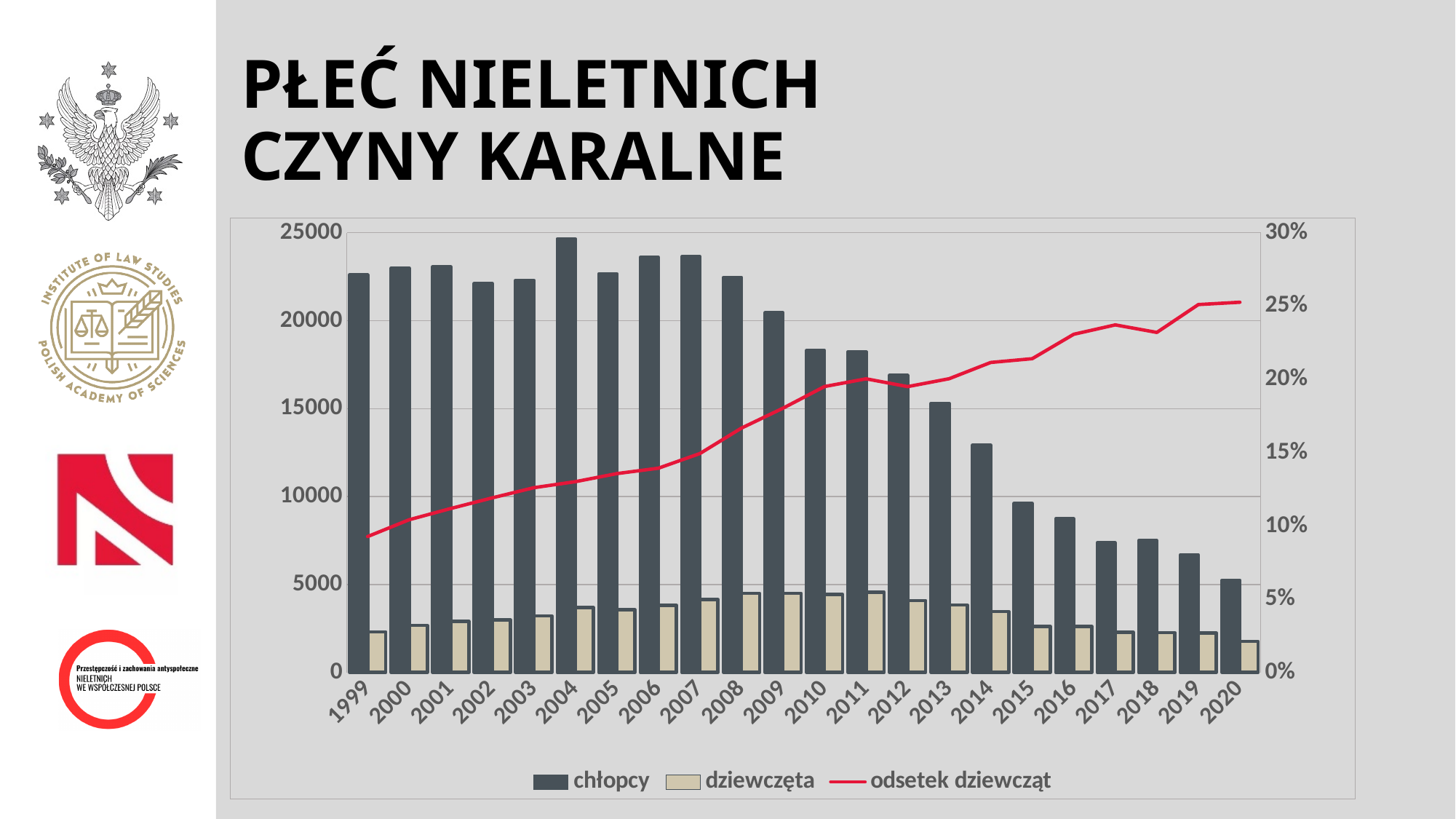
Is the value for chłopcy in 2004 greater or less than 20000? greater How many years are shown on the x axis? 22 Which is larger, the value for chłopcy in 1999 or in 2020? 1999 What kind of chart is shown on the slide? bar chart with a line In which year is the value for chłopcy highest? 2004 Does the odsetek dziewcząt line generally rise or fall from 1999 to 2020? rise In which year is the value for dziewczęta lowest? 2020 Is the value of odsetek dziewcząt in 1999 greater or less than 10%? less In which year is the value for chłopcy lowest? 2020 Is the value of odsetek dziewcząt in 2020 greater or less than 20%? greater How many series does the legend list? 3